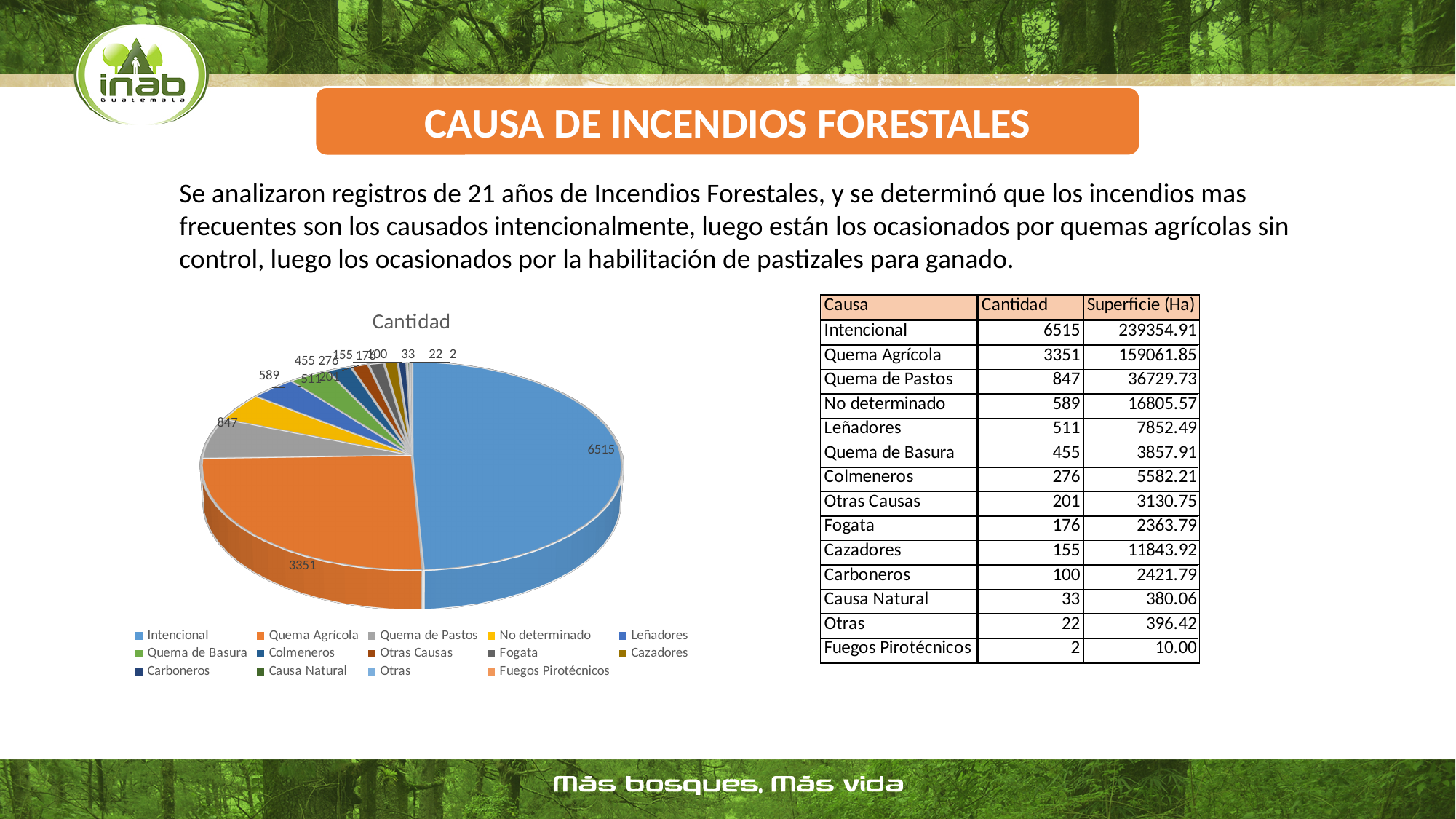
What is the difference between the Intencional and Quema Agrícola values in the pie chart? 3164 What colour is the Intencional slice in the pie chart? blue What is the value of the Quema de Pastos slice in the pie chart? 847 Which category has the smallest slice in the pie chart? Fuegos Pirotécnicos What is the title of the pie chart? Cantidad What is the value of the Intencional slice in the pie chart? 6515 Which is larger in the pie chart, Quema de Basura or Leñadores? Leñadores What is the value of the No determinado slice in the pie chart? 589 How many categories does the pie chart's legend list? 14 What kind of chart is shown on the slide? pie chart Which category has the largest slice in the pie chart? Intencional What is the value of the Quema Agrícola slice in the pie chart? 3351